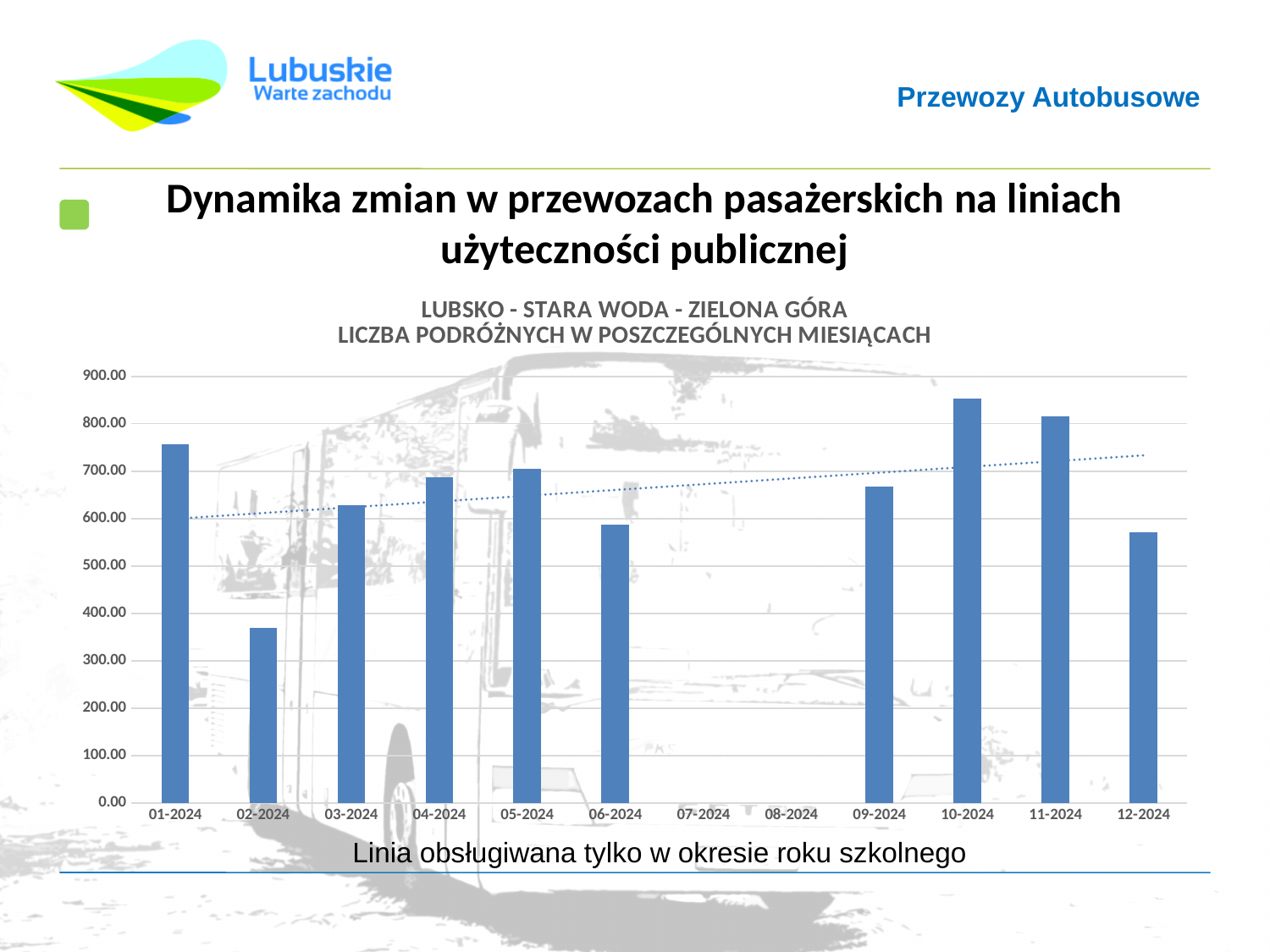
Among the months with a bar shown, which has the lowest number of passengers? 02-2024 Which is larger, the value for 11-2024 or the value for 12-2024? 11-2024 Which month has the highest number of passengers? 10-2024 Is the value for 12-2024 greater or less than 600? less How many months have a bar plotted in the chart? 10 Which bus line does the chart describe? LUBSKO - STARA WODA - ZIELONA GÓRA How many months are listed on the x axis? 12 Is the value for 10-2024 greater or less than 800? greater Is the value for 02-2024 greater or less than 400? less What kind of chart is shown on the slide? bar chart Does the dotted trend line rise or fall from left to right? rise